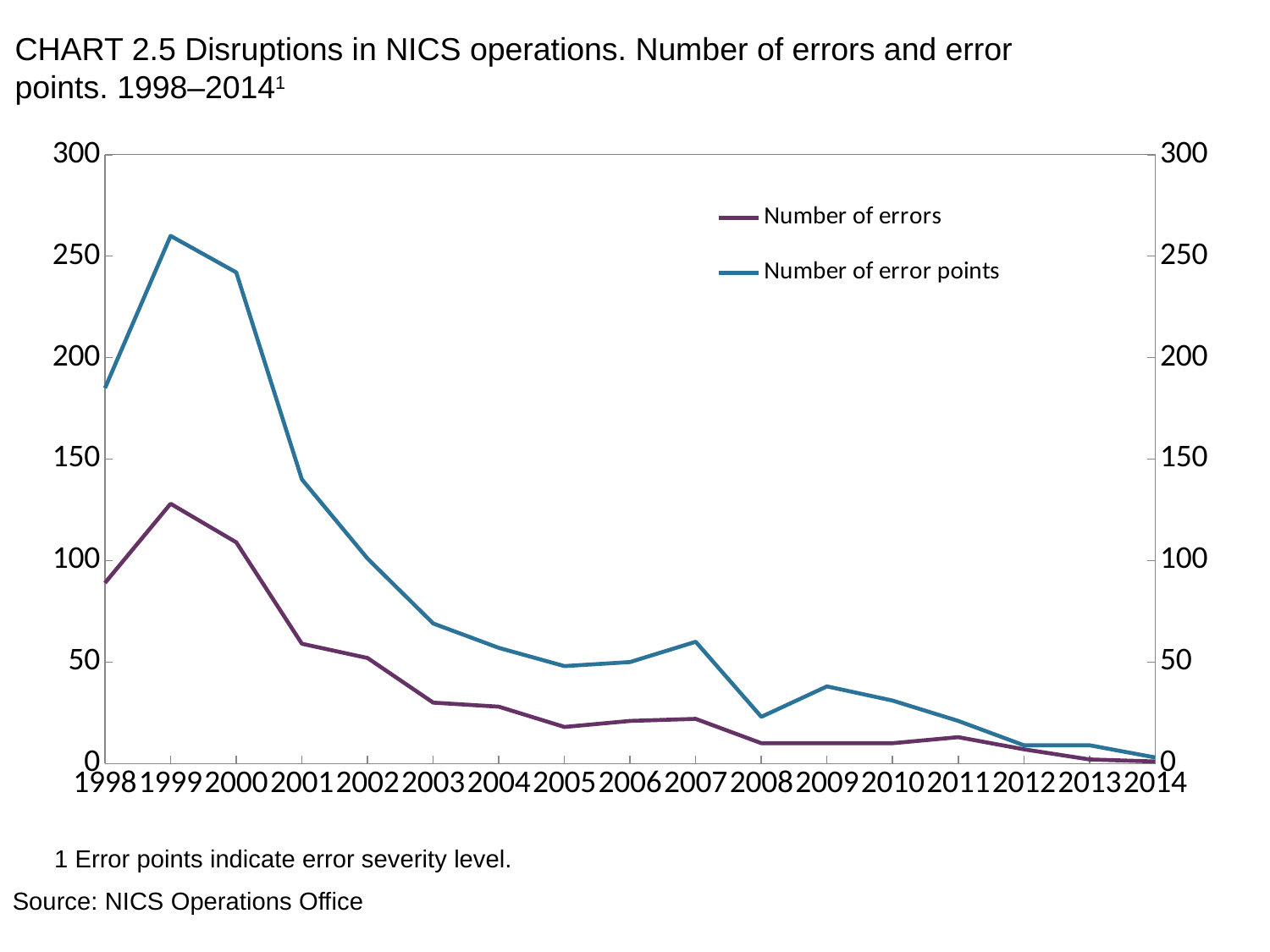
How many years are plotted along the x axis? 17 Overall, do the values for Number of error points rise or fall from 1999 to 2014? fall In which year is the Number of error points highest? 1999 Which is larger: the Number of error points in 2007 or in 2008? 2007 Is the Number of error points in 1999 greater or less than 250? greater What kind of chart is shown on the slide? line chart Is the Number of errors in 1998 greater or less than 100? less Is the Number of error points in 2001 greater or less than 150? less How many series does the legend list? 2 What are the two series named in the legend? Number of errors; Number of error points In which year is the Number of errors highest? 1999 In which year is the Number of error points lowest? 2014